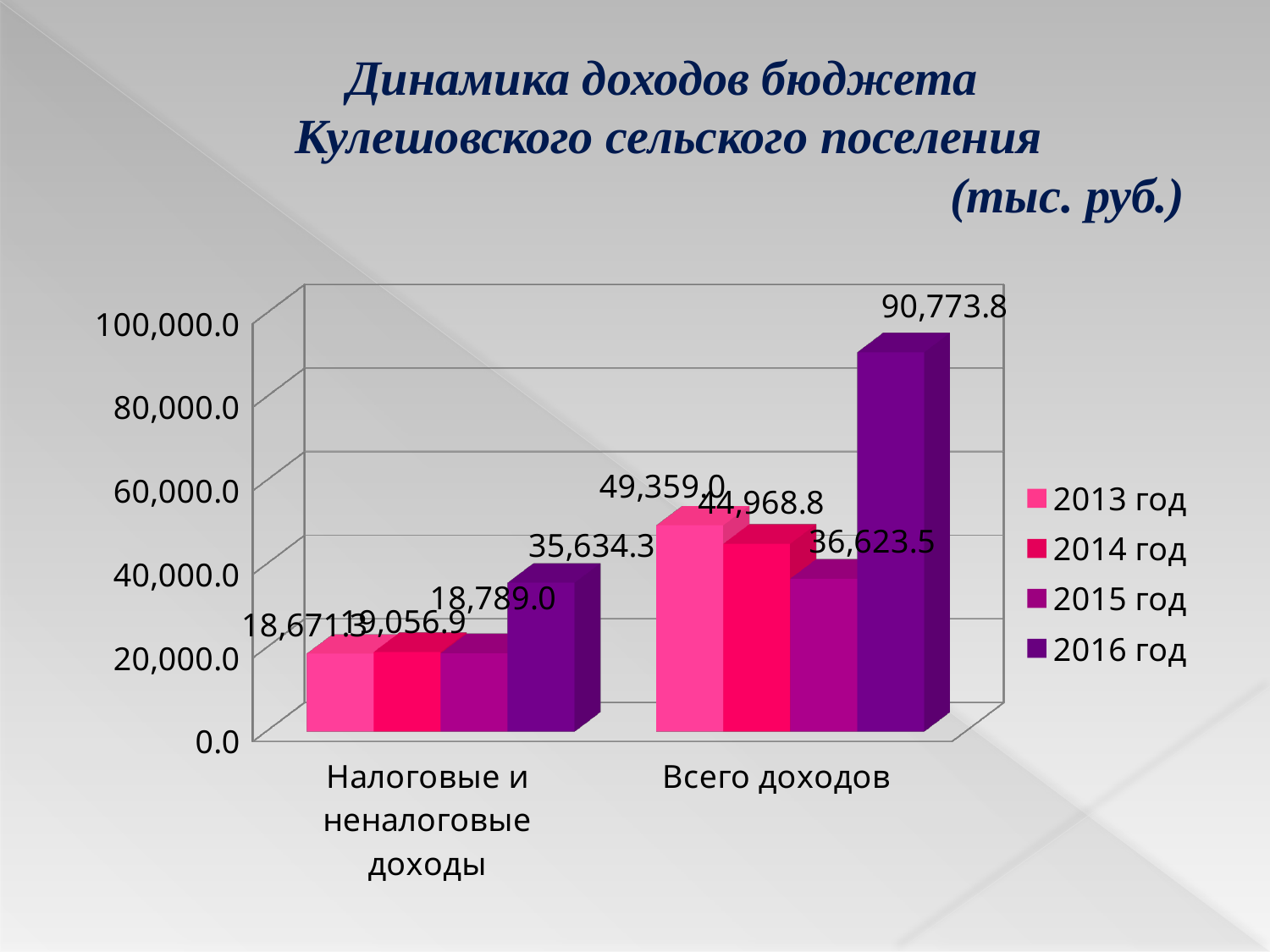
Which year has the highest value in the category Всего доходов? 2016 год How many categories are shown on the x axis? 2 What is the value for 2014 год in the category Всего доходов? 44,968.8 What is the difference between the 2016 год and 2015 год values in the category Всего доходов? 54,150.3 What is the value for 2015 год in the category Налоговые и неналоговые доходы? 18,789.0 Which is larger in the category Всего доходов: the value for 2013 год or for 2014 год? 2013 год What is the value for 2016 год in the category Всего доходов? 90,773.8 What is the value for 2016 год in the category Налоговые и неналоговые доходы? 35,634.3 How many series does the legend list? 4 Which year has the lowest value in the category Всего доходов? 2015 год Is the value for 2016 год in the category Всего доходов greater or less than 80,000.0? greater What type of chart is shown on the slide? bar chart